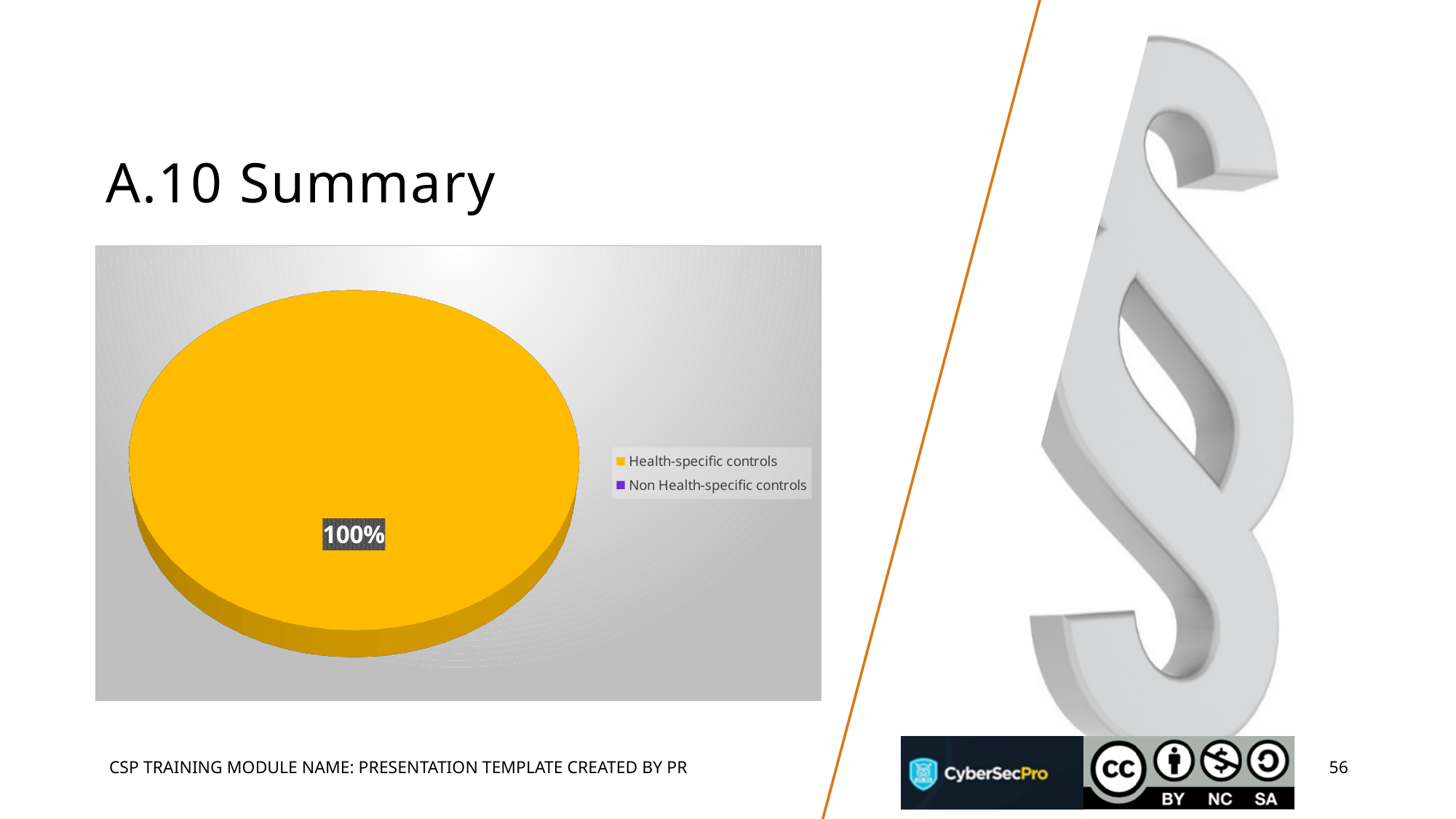
What kind of chart is shown on the slide? Pie chart How many entries does the legend of the pie chart list? 2 What share of the pie does Health-specific controls account for? 100% What percentage is shown on the data label of the pie chart? 100% What colour represents Health-specific controls in the pie chart? Orange What colour is assigned to Non Health-specific controls in the legend? Purple Is the share for Health-specific controls greater or less than 50%? greater Which category has the smallest share of the pie chart? Non Health-specific controls Which category makes up the largest share of the pie chart? Health-specific controls Which is larger in the pie chart, Health-specific controls or Non Health-specific controls? Health-specific controls